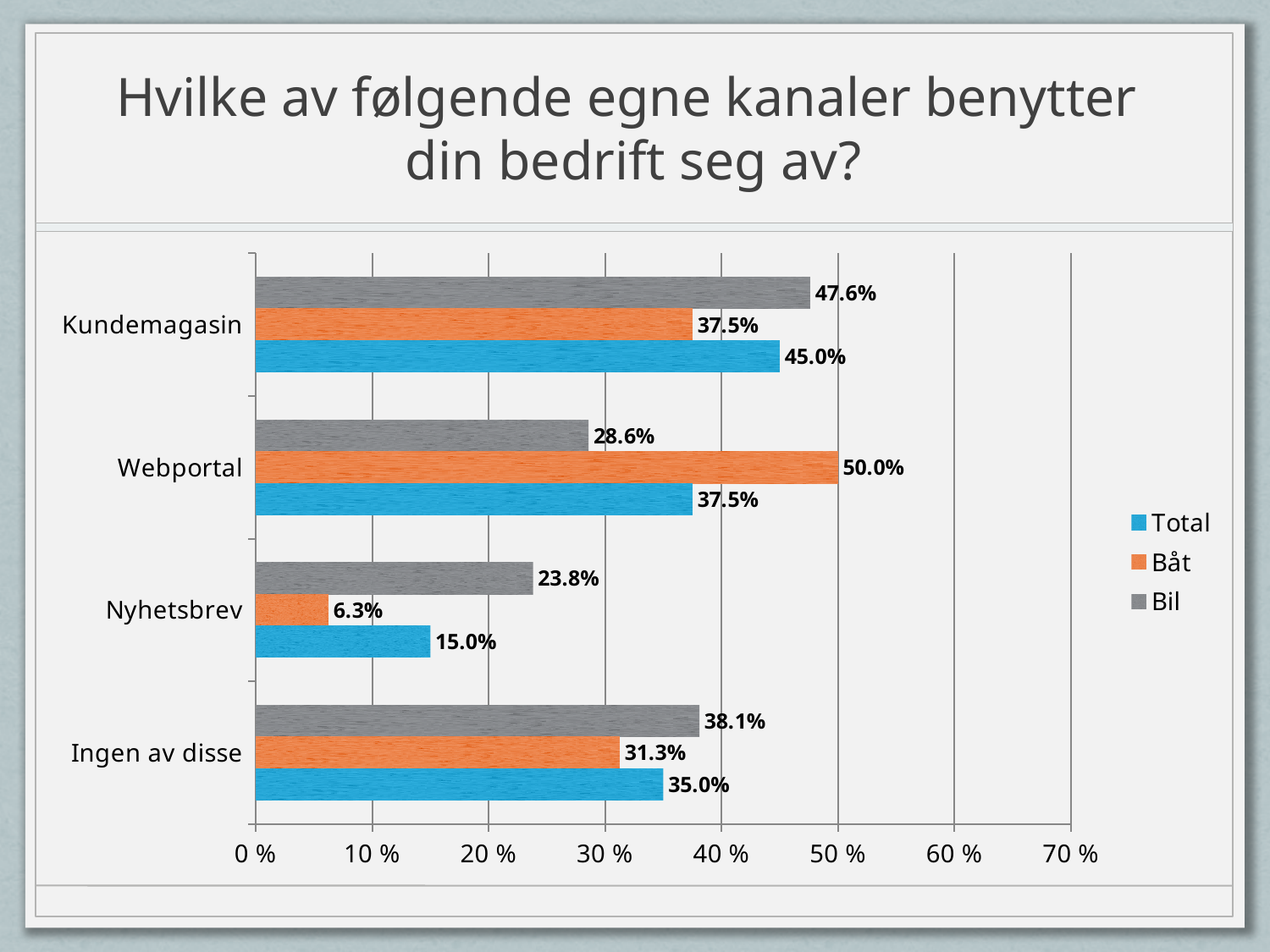
What is the value for Båt in the Webportal category? 50.0% How many series does the legend list? 3 What is the difference between the Bil and Båt values for Nyhetsbrev? 17.5% How many categories are shown on the chart? 4 Which series is shown in orange in the legend? Båt Which category has the highest value for the Båt series? Webportal What is the Total value for Nyhetsbrev? 15.0% What is the value for Bil in the Kundemagasin category? 47.6% What is the value for Båt in the Ingen av disse category? 31.3% What kind of chart is shown on the slide? Bar chart Which category has the lowest value for the Bil series? Nyhetsbrev Which is larger for Webportal: the Total value or the Bil value? Total